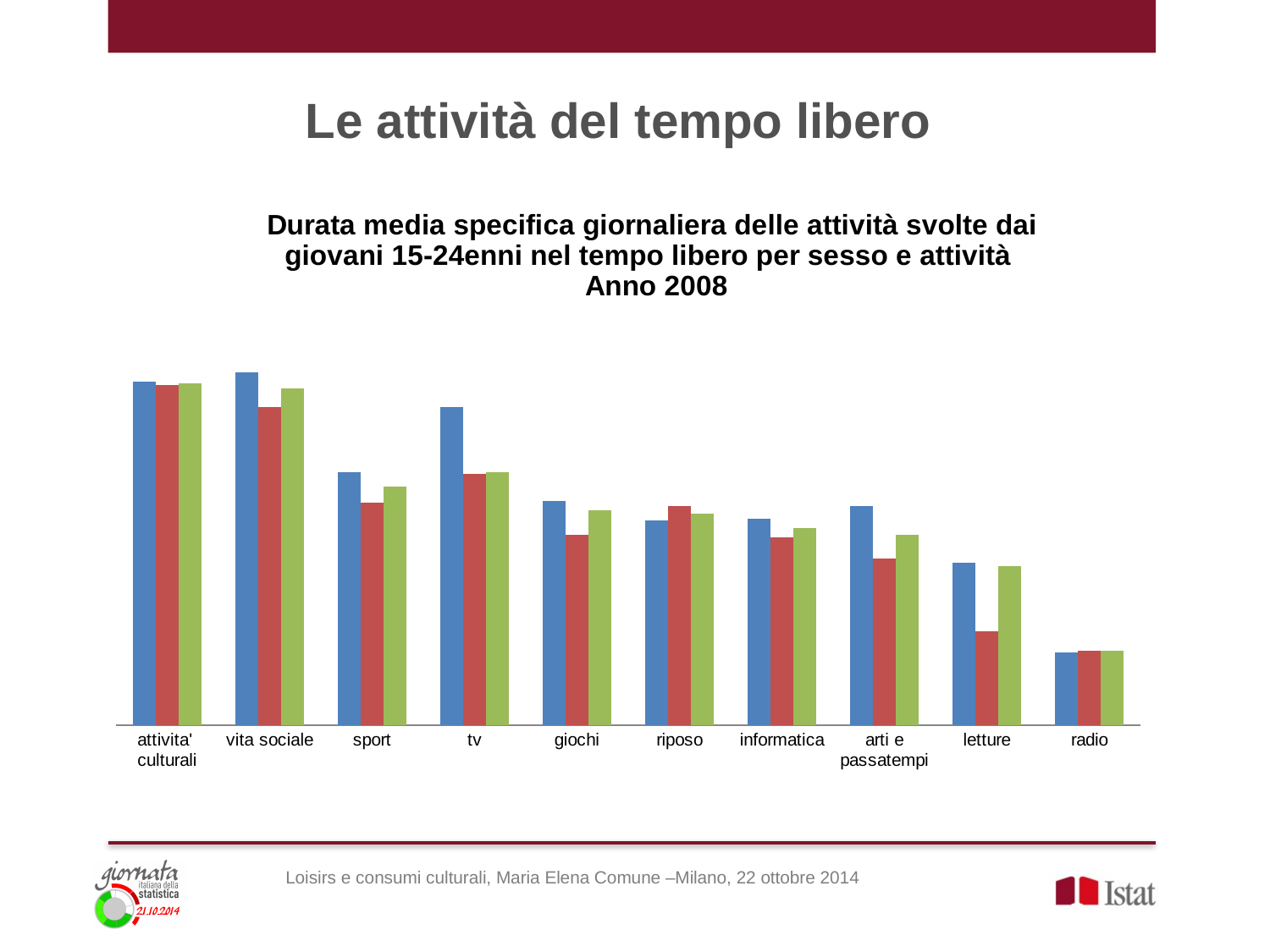
What year does the chart subtitle say the data refer to? 2008 How many bars are plotted for each activity category? 3 Is the blue bar for tv taller or shorter than the blue bar for sport? taller Which category has the tallest red bar? attivita' culturali How many activity categories are shown on the x axis of the chart? 10 For letture, which bar is taller: the blue bar or the green bar? blue What kind of chart is shown on the slide? bar chart Which category has the shortest blue bar? radio Which category has the tallest blue bar? vita sociale For arti e passatempi, which bar is taller: the blue bar or the red bar? blue Do the blue bars generally rise or fall moving from left to right along the x axis? fall Which category has the shortest green bar? radio